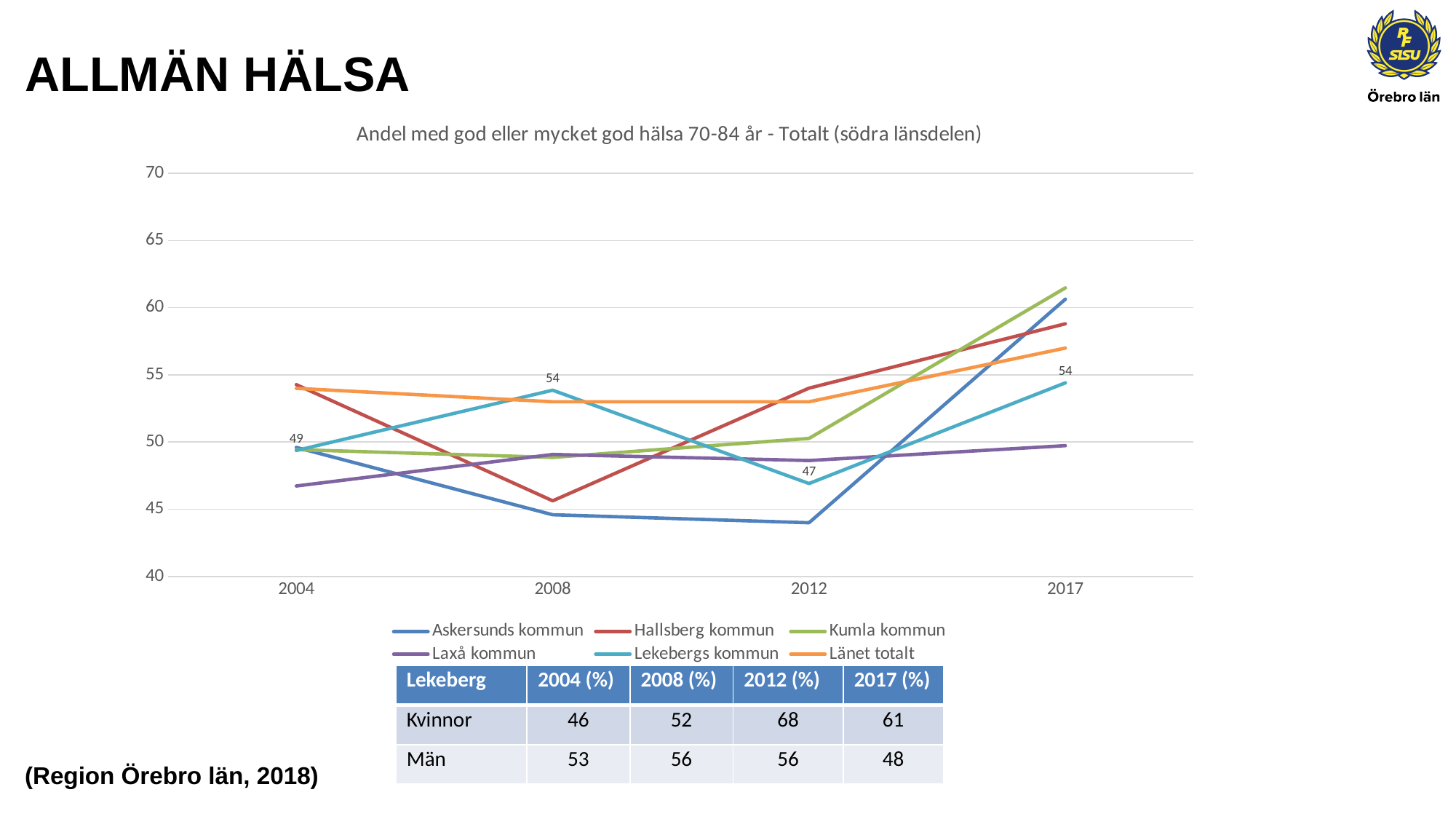
Is the value for Hallsberg kommun in 2017 greater or less than 55? greater How many years are shown on the x axis of the chart? 4 What is the difference between the Lekebergs kommun values for 2008 and 2012? 7 Which series has the lowest value in 2012? Askersunds kommun What is the value for Lekebergs kommun in 2008? 54 What is the value for Lekebergs kommun in 2012? 47 What kind of chart is shown on the slide? line chart How many series does the chart's legend list? 6 Which series has the lowest value in 2017? Laxå kommun In 2004, which is larger: Hallsberg kommun or Laxå kommun? Hallsberg kommun What is the value for Lekebergs kommun in 2004? 49 Is the value for Askersunds kommun in 2012 greater or less than 45? less